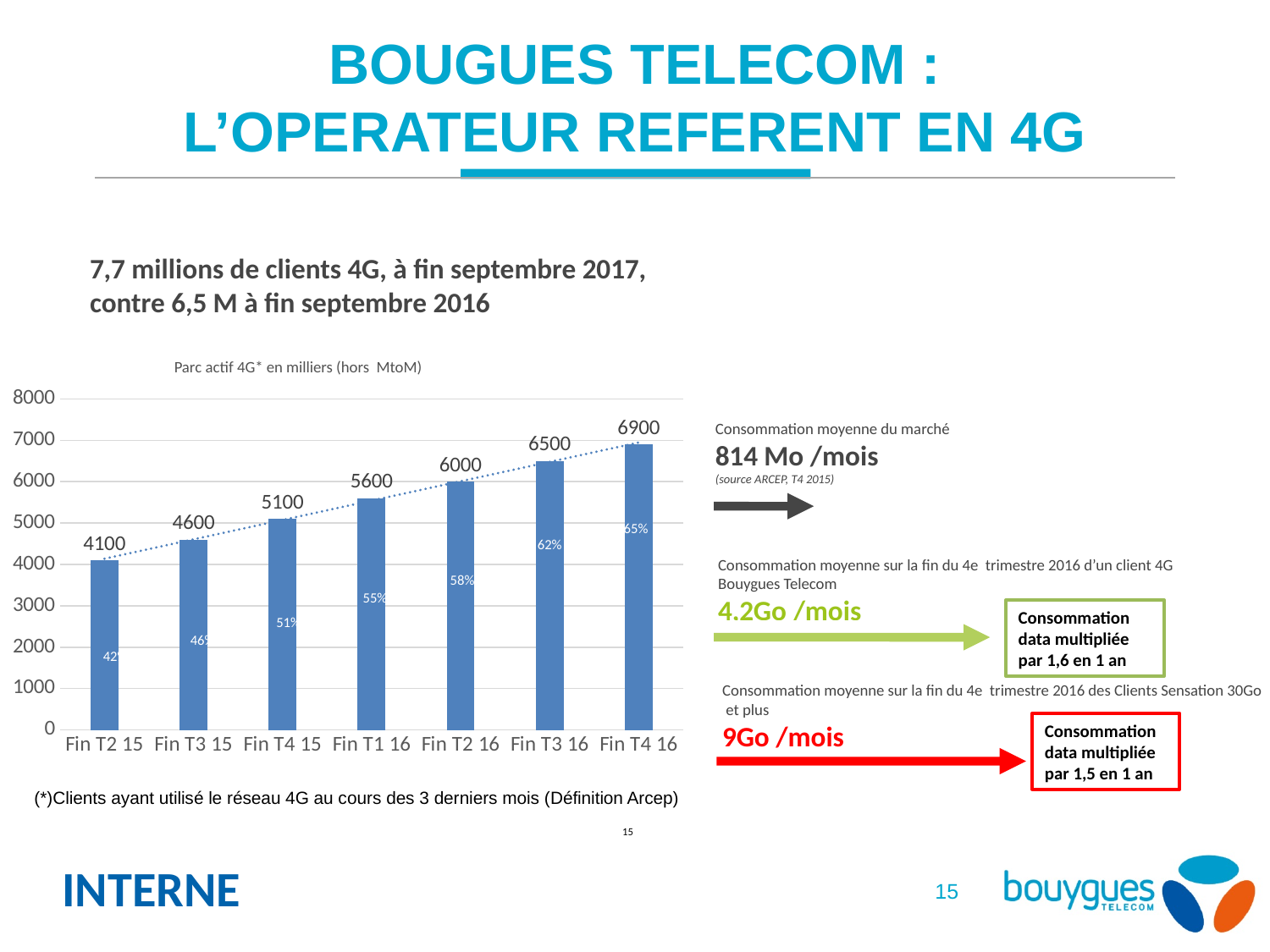
In the 'Parc actif 4G* en milliers (hors MtoM)' chart, which is larger: the value for Fin T4 15 or the value for Fin T3 15? Fin T4 15 What percentage label is printed inside the Fin T3 16 bar in the 'Parc actif 4G* en milliers (hors MtoM)' chart? 62% How many categories are shown on the x axis of the 'Parc actif 4G* en milliers (hors MtoM)' chart? 7 What is the difference between the values for Fin T4 16 and Fin T2 15 in the 'Parc actif 4G* en milliers (hors MtoM)' chart? 2800 Do the values in the 'Parc actif 4G* en milliers (hors MtoM)' chart rise or fall from Fin T2 15 to Fin T4 16? Rise What is the value for Fin T1 16 in the 'Parc actif 4G* en milliers (hors MtoM)' chart? 5600 What is the difference between the values for Fin T3 16 and Fin T2 16 in the 'Parc actif 4G* en milliers (hors MtoM)' chart? 500 What is the value for Fin T2 15 in the 'Parc actif 4G* en milliers (hors MtoM)' chart? 4100 Which category has the highest value in the 'Parc actif 4G* en milliers (hors MtoM)' chart? Fin T4 16 What is the value for Fin T4 16 in the 'Parc actif 4G* en milliers (hors MtoM)' chart? 6900 What kind of chart is the 'Parc actif 4G* en milliers (hors MtoM)' chart? Bar chart Which category has the lowest value in the 'Parc actif 4G* en milliers (hors MtoM)' chart? Fin T2 15